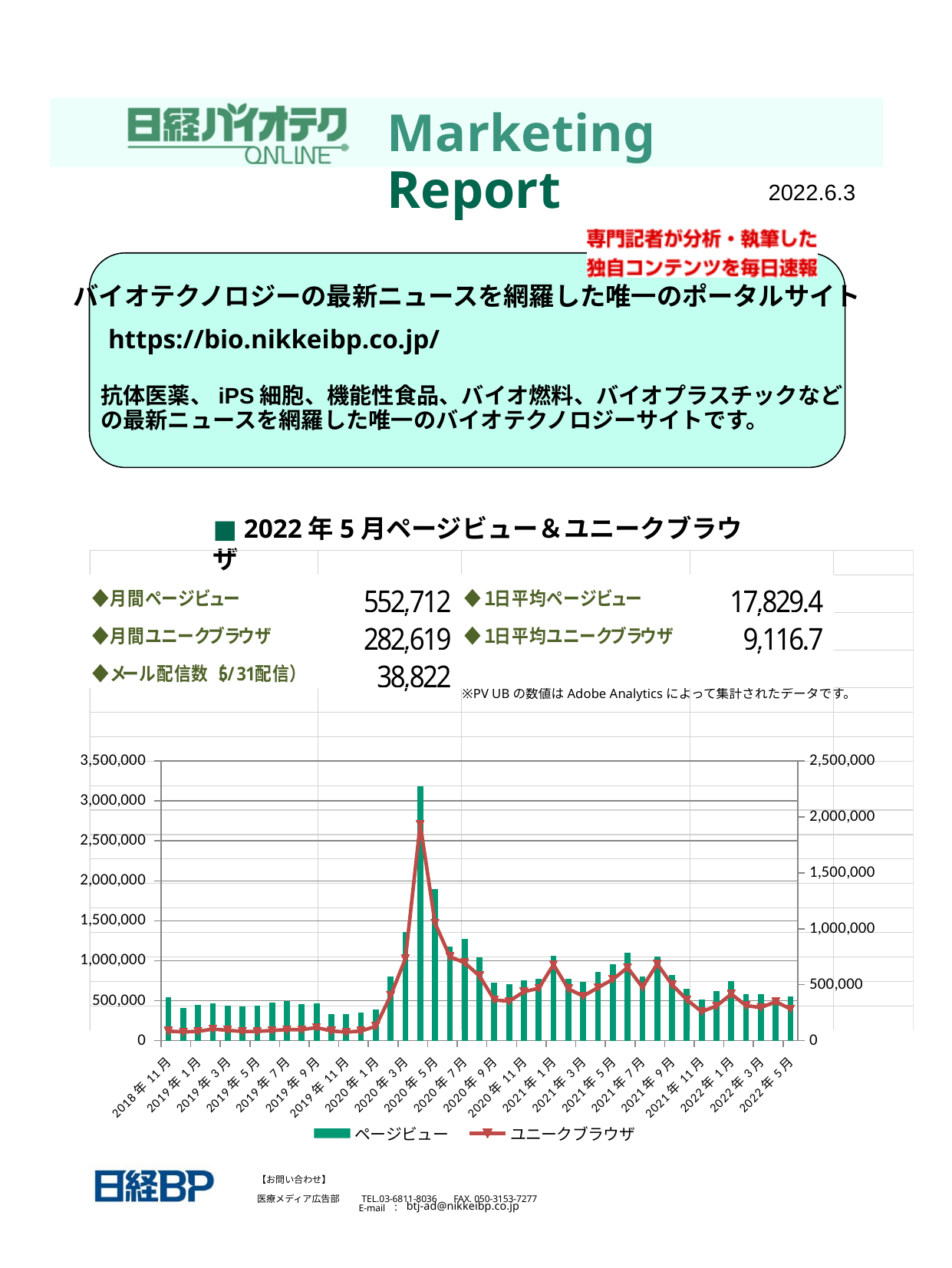
What is the first month label on the chart's x axis? 2018年11月 What kind of chart is shown on the slide? A combination bar and line chart Is the page view (ページビュー) value for 2022年5月 greater or less than 1,000,000? less Is the page view (ページビュー) value for 2018年11月 greater or less than 1,000,000? less Which month has the larger page view (ページビュー) bar, 2021年1月 or 2021年3月? 2021年1月 Is the peak of the unique browser (ユニークブラウザ) line greater or less than 1,500,000 on the right axis? greater What is the highest tick value on the left vertical axis of the chart? 3,500,000 Do page views (ページビュー) rise or fall from 2020年5月 to 2020年9月? fall According to the figures printed above the chart, what is the monthly page view count (月間ページビュー)? 552,712 How many series does the chart legend list? 2 What are the two series named in the chart legend? ページビュー and ユニークブラウザ